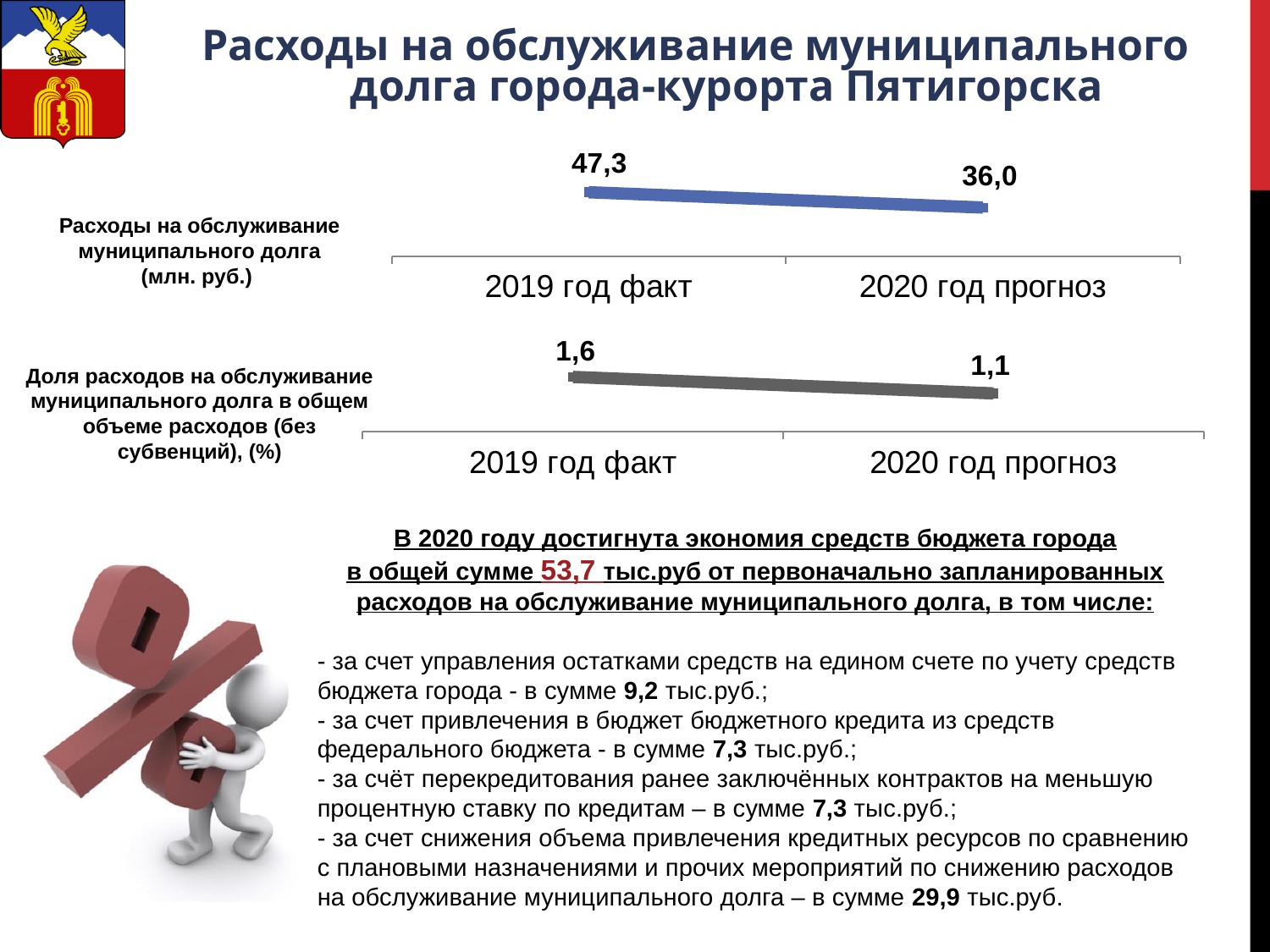
На нижнем графике «Доля расходов на обслуживание муниципального долга» какой год имеет наименьшее значение? 2020 год прогноз На верхнем графике «Расходы на обслуживание муниципального долга (млн. руб.)» какое значение указано для 2020 года (прогноз)? 36,0 На нижнем графике «Доля расходов на обслуживание муниципального долга в общем объеме расходов (без субвенций), (%)» какое значение указано для 2019 года (факт)? 1,6 На верхнем графике «Расходы на обслуживание муниципального долга (млн. руб.)» какой год имеет наибольшее значение? 2019 год факт На нижнем графике «Доля расходов на обслуживание муниципального долга» на сколько значение 2019 года больше значения 2020 года? 0,5 На верхнем графике «Расходы на обслуживание муниципального долга (млн. руб.)» какое значение указано для 2019 года (факт)? 47,3 На нижнем графике «Доля расходов на обслуживание муниципального долга» значение растёт или падает от 2019 года к 2020 году? падает На нижнем графике «Доля расходов на обслуживание муниципального долга в общем объеме расходов (без субвенций), (%)» какое значение указано для 2020 года (прогноз)? 1,1 На верхнем графике «Расходы на обслуживание муниципального долга (млн. руб.)» значение растёт или падает от 2019 года к 2020 году? падает Какого типа верхний график «Расходы на обслуживание муниципального долга (млн. руб.)»? линейный график Сколько точек данных показано на верхнем графике «Расходы на обслуживание муниципального долга (млн. руб.)»? 2 На верхнем графике «Расходы на обслуживание муниципального долга (млн. руб.)» на сколько значение 2019 года больше значения 2020 года? 11,3